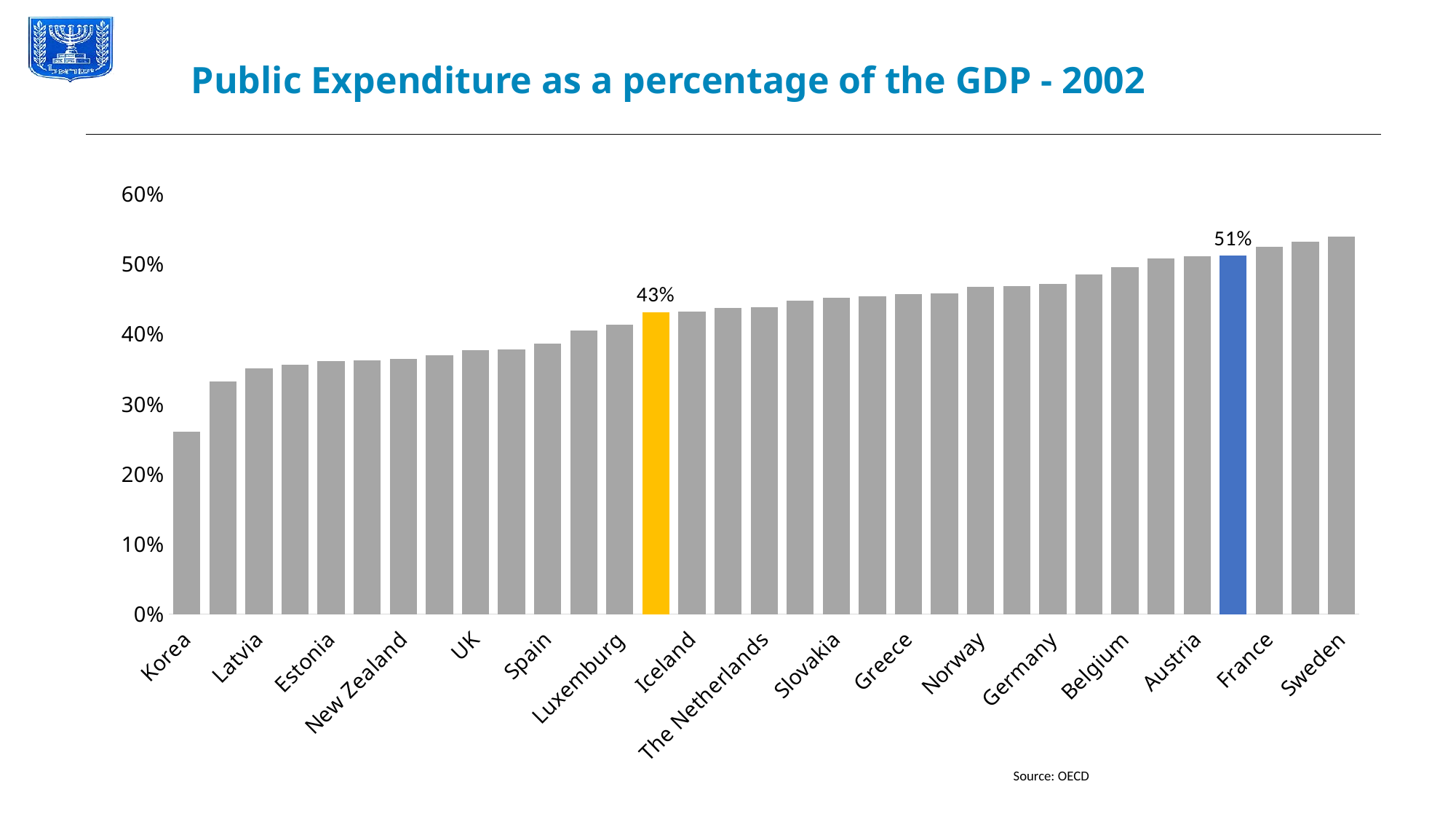
What kind of chart is shown on the slide? Bar chart Is the value for Greece greater or less than 40%? greater Which has a higher value, Germany or the UK? Germany Is the value for Sweden greater or less than 50%? greater What is the title of the chart? Public Expenditure as a percentage of the GDP - 2002 What is the difference between the values printed on the blue bar and the yellow bar? 8 percentage points What value is printed above the blue highlighted bar? 51% Which labeled country has the highest public expenditure as a percentage of GDP? Sweden Do the bar values rise or fall from left to right along the x axis? Rise What value is printed above the yellow highlighted bar? 43% Which labeled country has the lowest public expenditure as a percentage of GDP? Korea Is the value for Korea greater or less than 30%? less